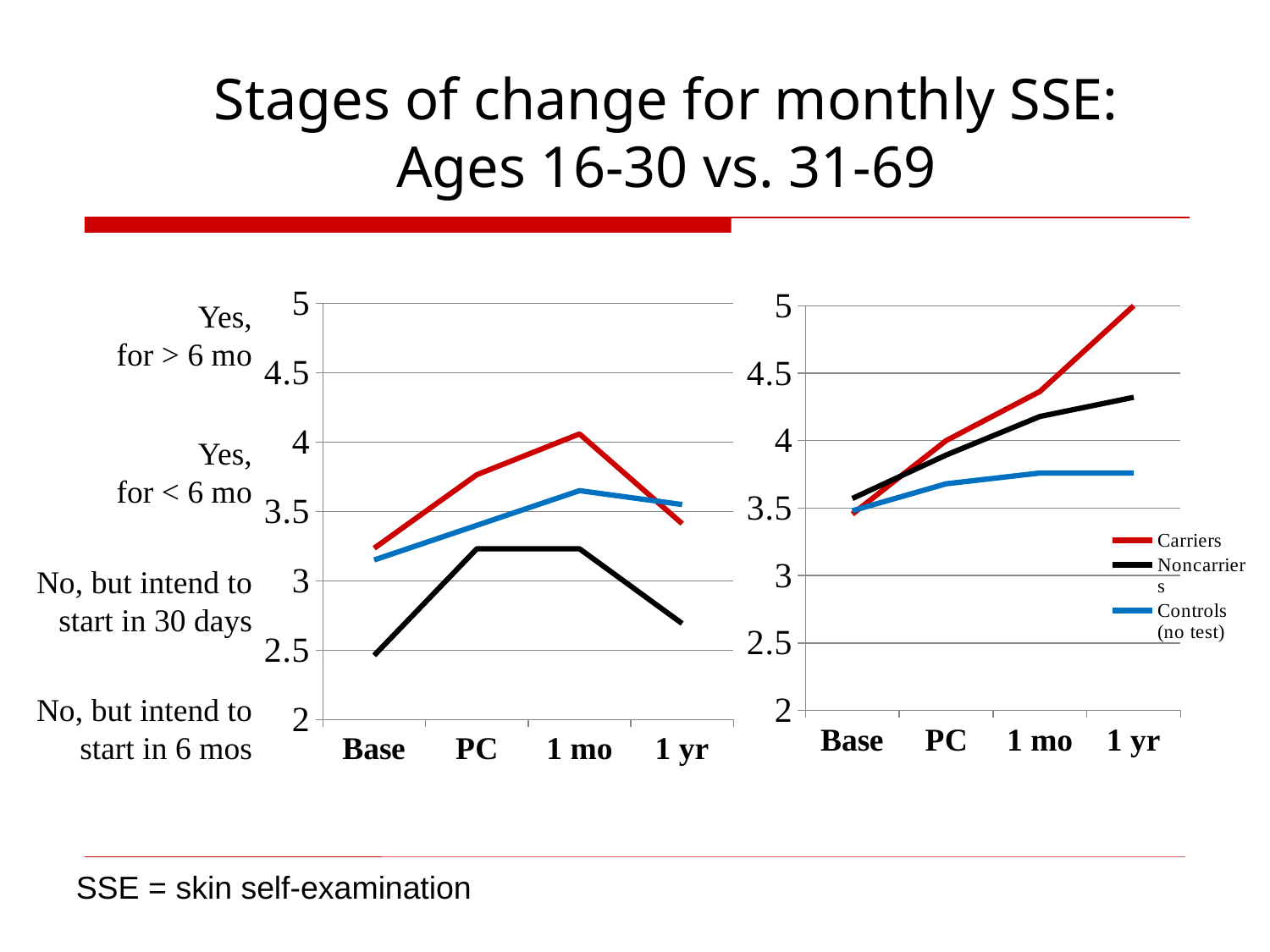
In the right chart, which is larger at 1 yr: Noncarriers or Controls (no test)? Noncarriers What kind of chart is the left chart on the slide? line chart In the right chart, is the value for Carriers at 1 yr greater or less than 4.5? greater In the right chart, does the Carriers line rise or fall from Base to 1 yr? rise In the left chart, is the value for Noncarriers at 1 yr greater or less than 3? less In the left chart, which series is highest at 1 mo? Carriers In the right chart, is the value for Controls (no test) at 1 yr greater or less than 4? less In the left chart, which series is lowest at 1 yr? Noncarriers How many series does the legend of the right chart list? 3 In the right chart, which series is highest at 1 yr? Carriers How many points are on the x axis of the right chart? 4 What are the three legend entries shown on the right chart? Carriers, Noncarriers, Controls (no test)